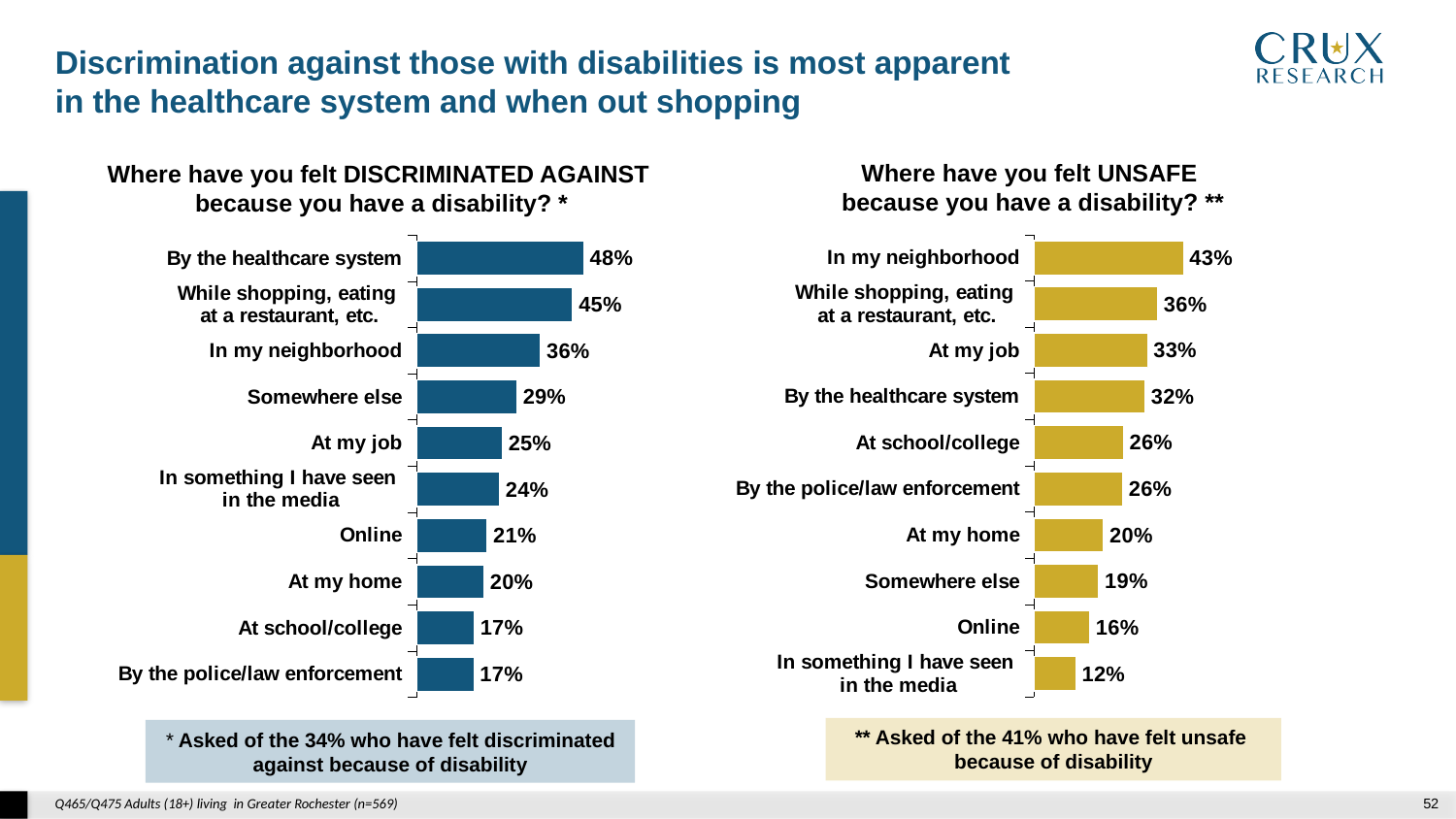
In the 'Where have you felt UNSAFE' chart, which category has the lowest value? In something I have seen in the media In the 'Where have you felt UNSAFE' chart, what is the difference between 'In my neighborhood' and 'Online'? 27% In the 'Where have you felt DISCRIMINATED AGAINST' chart, what is the value for 'By the healthcare system'? 48% In the 'Where have you felt DISCRIMINATED AGAINST' chart, which category has the highest value? By the healthcare system How many categories are shown in the 'Where have you felt DISCRIMINATED AGAINST' chart? 10 In the 'Where have you felt DISCRIMINATED AGAINST' chart, what is the value for 'Somewhere else'? 29% In the 'Where have you felt UNSAFE' chart, what is the value for 'At my job'? 33% What colour are the bars in the 'Where have you felt UNSAFE' chart? Gold Which is larger: 'Online' in the 'Where have you felt DISCRIMINATED AGAINST' chart or 'Online' in the 'Where have you felt UNSAFE' chart? Online in the DISCRIMINATED AGAINST chart In the 'Where have you felt DISCRIMINATED AGAINST' chart, what is the difference between 'By the healthcare system' and 'In my neighborhood'? 12% What type of chart is the 'Where have you felt UNSAFE' chart? Bar chart In the 'Where have you felt UNSAFE' chart, which category has the highest value? In my neighborhood